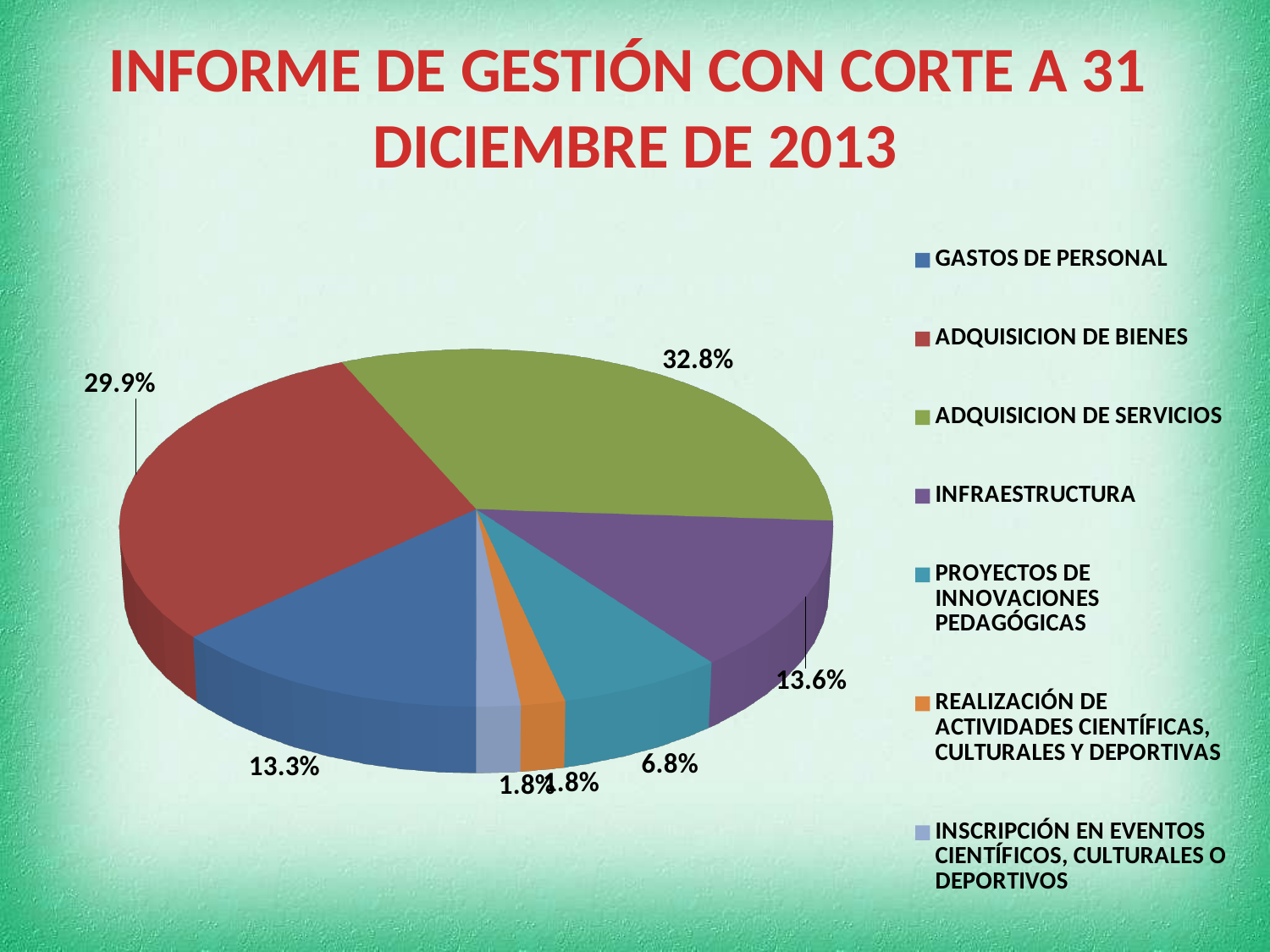
What percentage is shown for ADQUISICION DE BIENES? 29.9% Which is larger, the share for INFRAESTRUCTURA or the share for GASTOS DE PERSONAL? INFRAESTRUCTURA What is the value for GASTOS DE PERSONAL? 13.3% What is the difference between the shares of ADQUISICION DE SERVICIOS and ADQUISICION DE BIENES? 2.9% How many slices does the pie chart have? 7 What colour is the slice for ADQUISICION DE BIENES? Red What share of the pie does ADQUISICION DE SERVICIOS represent? 32.8% What percentage does INFRAESTRUCTURA account for? 13.6% What is the share for PROYECTOS DE INNOVACIONES PEDAGÓGICAS? 6.8% What is the smallest percentage shown on the pie chart? 1.8% What type of chart is shown on the slide? Pie chart Which category has the largest slice of the pie? ADQUISICION DE SERVICIOS